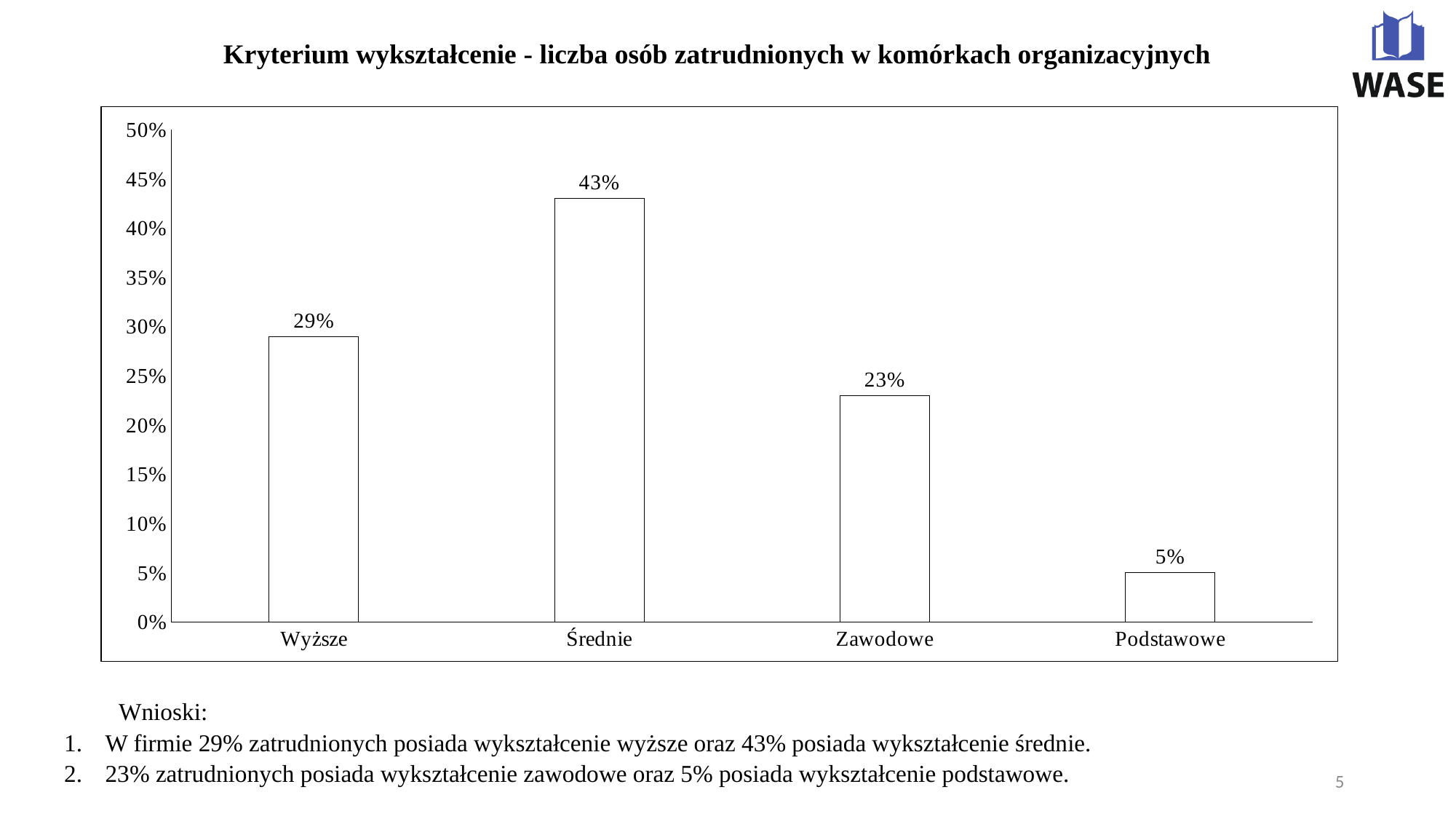
What kind of chart is shown on the slide? Bar chart What is the value for Podstawowe? 5% What is the title of the chart? Kryterium wykształcenie - liczba osób zatrudnionych w komórkach organizacyjnych What is the value for Średnie? 43% How many categories are shown on the x axis? 4 Which is larger, the value for Wyższe or the value for Zawodowe? Wyższe What is the value for Wyższe? 29% What is the value for Zawodowe? 23% What is the difference between the values for Zawodowe and Podstawowe? 18% Which category has the highest value? Średnie Which category has the lowest value? Podstawowe What is the difference between the values for Średnie and Wyższe? 14%